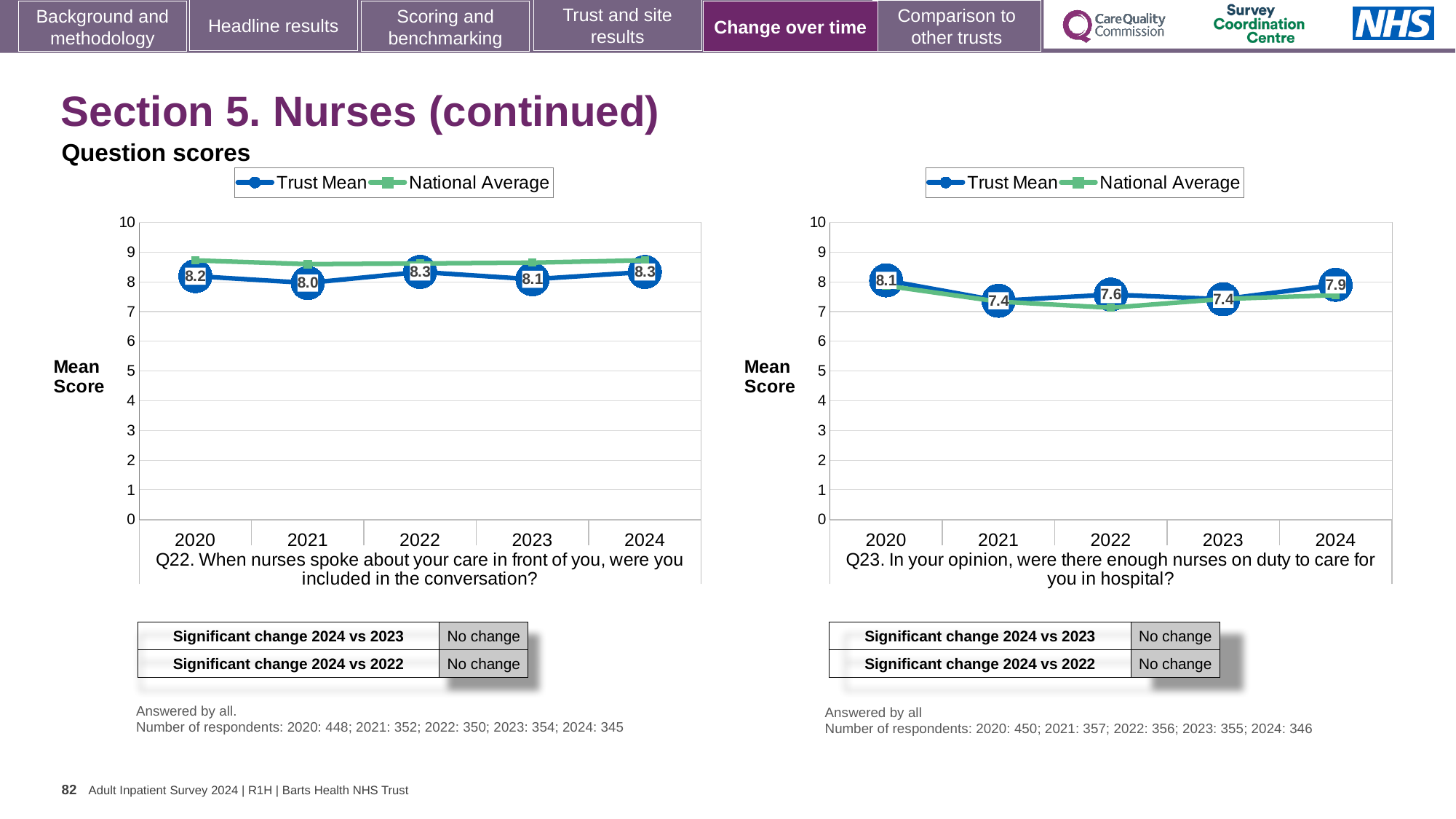
On the Q22 chart (left), is the National Average for 2020 greater or less than 8? greater What type of chart is used for Q22 (left)? Line chart How many years are plotted on the Q23 chart (right)? 5 How many series does the legend of the Q22 chart (left) list? 2 On the Q22 chart (left), what is the Trust Mean score for 2022? 8.3 On the Q22 chart (left), which year has the lowest Trust Mean score? 2021 On the Q23 chart (right), what is the difference between the Trust Mean scores for 2020 and 2021? 0.7 On the Q23 chart (right), is the National Average for 2022 greater or less than 8? less On the Q23 chart (right), which year has the highest Trust Mean score? 2020 On the Q23 chart (right), does the Trust Mean rise or fall from 2023 to 2024? Rise On the Q22 chart (left), is the Trust Mean score for 2021 or 2022 higher? 2022 On the Q23 chart (right), what is the Trust Mean score for 2021? 7.4